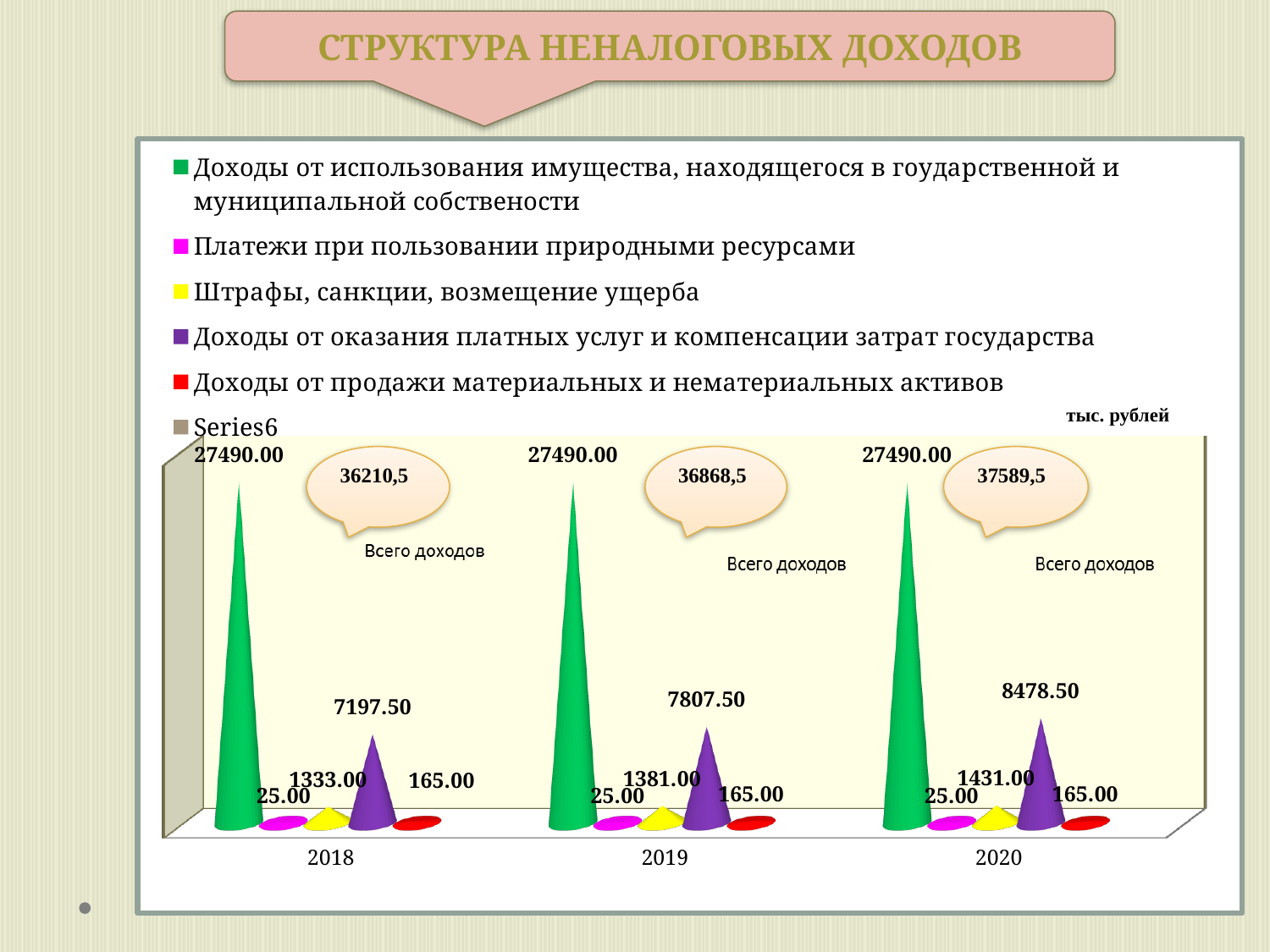
How many series does the legend list? 6 What is the value for Доходы от оказания платных услуг и компенсации затрат государства in 2020? 8478.50 Do the values for Доходы от оказания платных услуг и компенсации затрат государства rise or fall from 2018 to 2020? rise How many years are shown on the x axis? 3 Which is larger: Штрафы, санкции, возмещение ущерба in 2019 or Доходы от продажи материальных и нематериальных активов in 2019? Штрафы, санкции, возмещение ущерба What is the value for Штрафы, санкции, возмещение ущерба in 2018? 1333.00 What is the value for Доходы от продажи материальных и нематериальных активов in 2020? 165.00 What total income (Всего доходов) is shown in the callout for 2019? 36868,5 What is the difference between the values for Доходы от оказания платных услуг и компенсации затрат государства in 2020 and 2018? 1281.00 Which series has the lowest value in 2020? Платежи при пользовании природными ресурсами Which series has the highest value in 2018? Доходы от использования имущества, находящегося в гоударственной и муниципальной собствености What is the value for Доходы от использования имущества, находящегося в гоударственной и муниципальной собствености in 2019? 27490.00